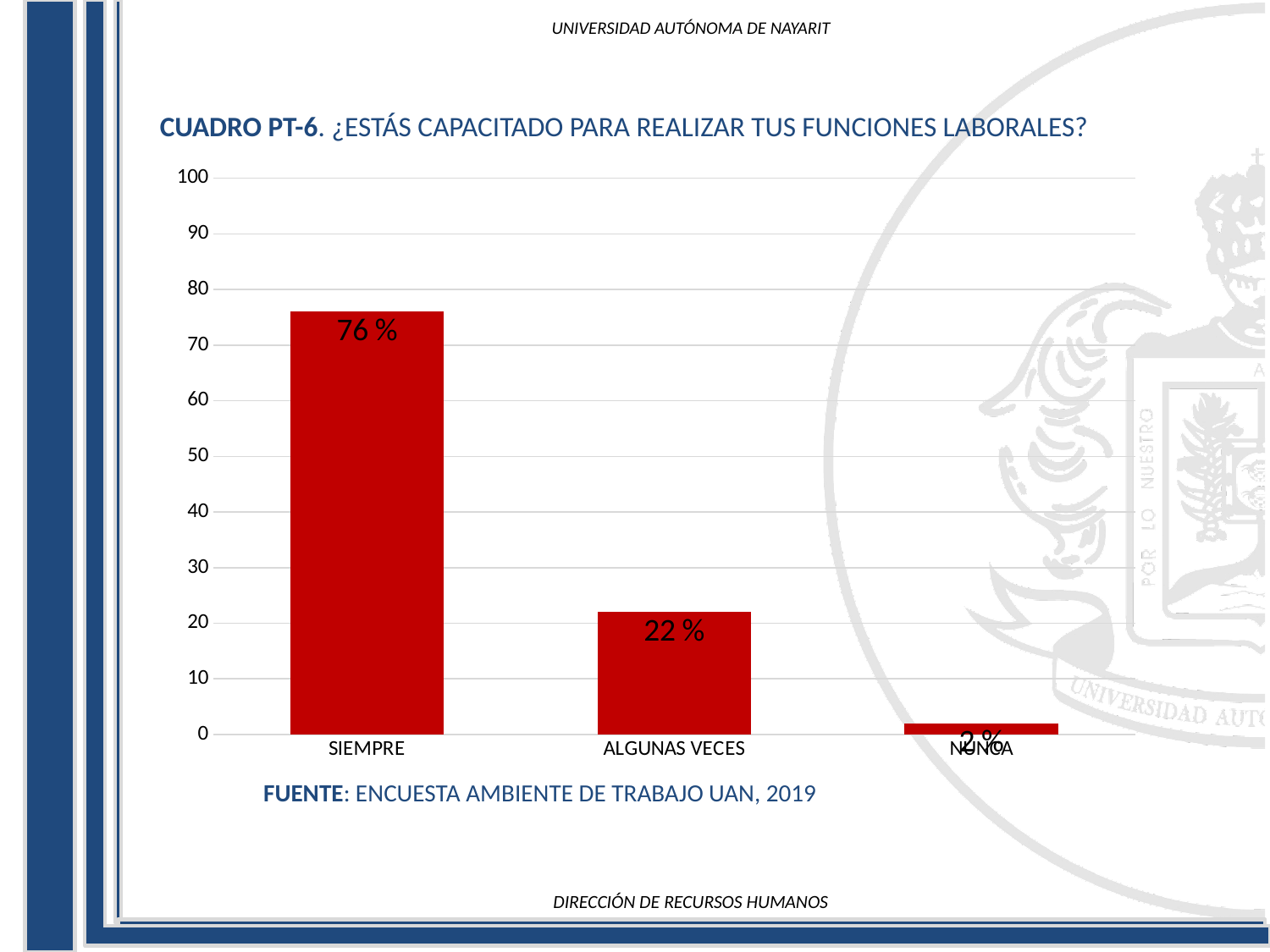
Which is larger, the value for SIEMPRE or the value for ALGUNAS VECES? SIEMPRE What is the value for ALGUNAS VECES? 22 % How many categories are shown in the chart? 3 Which category has the lowest value? NUNCA What kind of chart is shown on the slide? bar chart What is the difference between the values for SIEMPRE and ALGUNAS VECES? 54 % Which category has the highest value? SIEMPRE What is the value for SIEMPRE? 76 % Is the value for SIEMPRE greater or less than 70? greater What is the value for NUNCA? 2 % What is the difference between the values for ALGUNAS VECES and NUNCA? 20 % What is the source cited below the chart? ENCUESTA AMBIENTE DE TRABAJO UAN, 2019